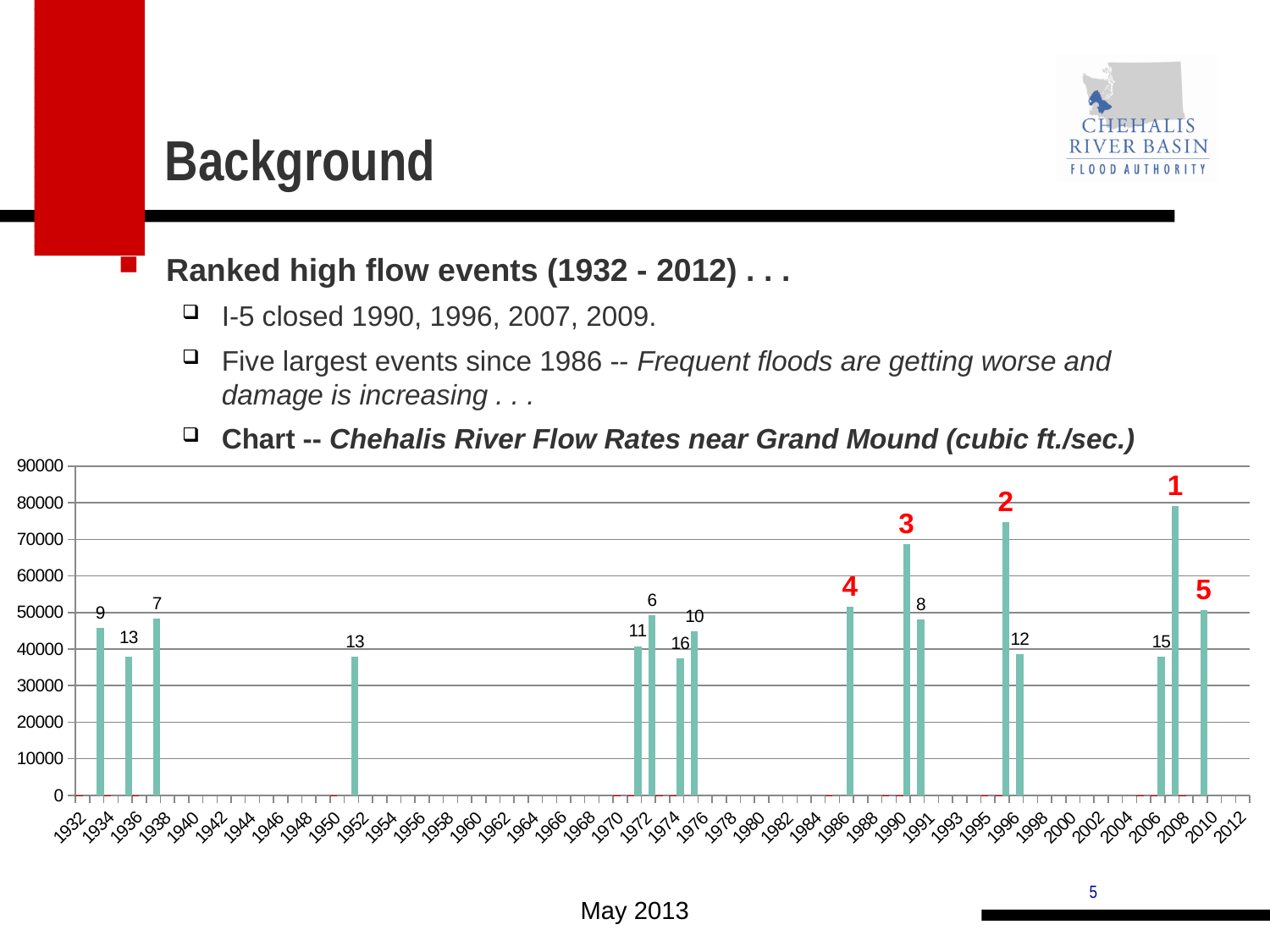
How many bars in the chart carry a rank label? 16 Is the value of the bar labeled 1 greater or less than 70000? greater What is the title of the chart according to the slide text? Chehalis River Flow Rates near Grand Mound (cubic ft./sec.) Is the value of the bar labeled 16 greater or less than 40000? less Which is larger, the bar labeled 2 or the bar labeled 3? the bar labeled 2 What kind of chart is shown on the slide? bar chart Which bar is the tallest in the chart? the bar labeled 1 What is the highest value shown on the vertical axis of the chart? 90000 Is the value of the bar labeled 3 greater or less than 60000? greater Which is larger, the bar labeled 5 or the bar labeled 1? the bar labeled 1